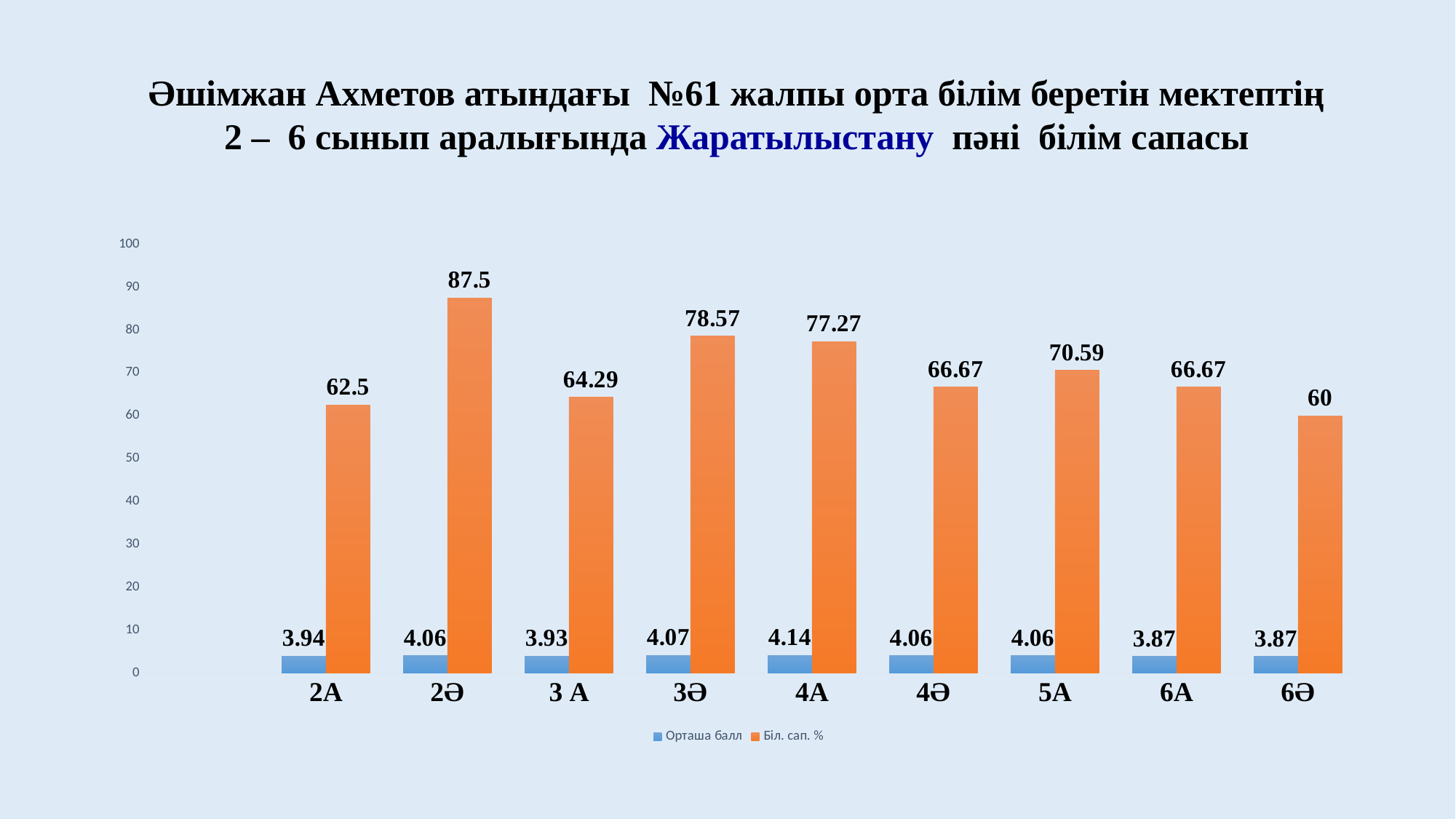
What is the Біл. сап. % value for class 3 А? 64.29 Is the Біл. сап. % value for 5А greater or less than 80? less Which class has the highest Біл. сап. % value? 2Ә What kind of chart is shown on the slide? bar chart What is the Біл. сап. % value for class 2Ә? 87.5 Which colour represents the Орташа балл series? blue What is the difference between the Біл. сап. % values for 2Ә and 2А? 25 Which class has the larger Біл. сап. % value, 3Ә or 4А? 3Ә How many series does the legend list? 2 Which class has the lowest Біл. сап. % value? 6Ә How many classes are shown on the x axis? 9 What is the Орташа балл value for class 4А? 4.14